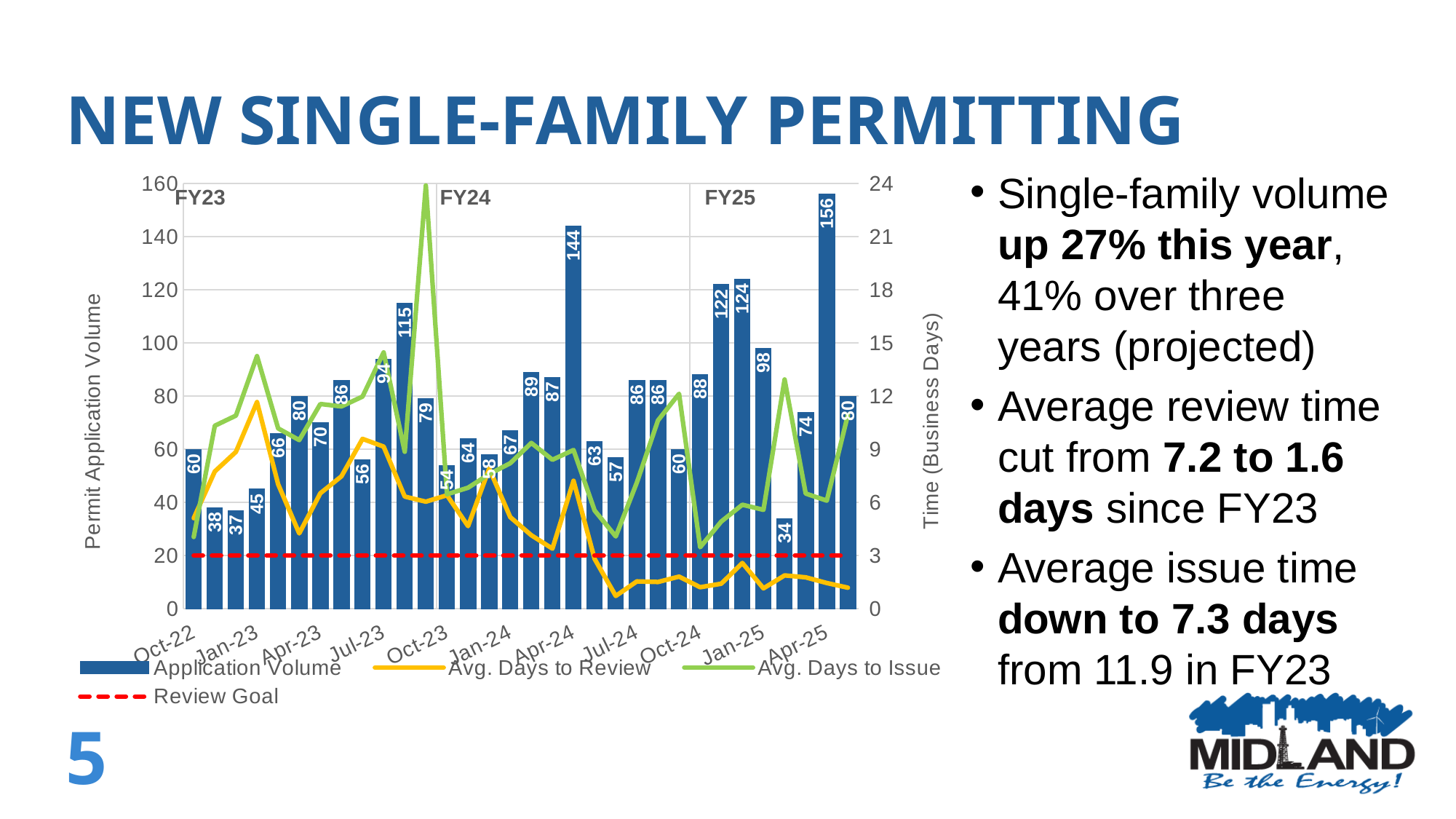
What is the highest Application Volume value shown on the chart? 156 What is the Application Volume for Oct-22? 60 What is the difference in Application Volume between Apr-25 and Apr-24? 12 Is the Review Goal line greater or less than 6 business days? less What is the maximum value shown on the right-hand Time (Business Days) axis? 24 Which has a higher Application Volume, Jan-25 or Jan-24? Jan-25 How many series does the chart legend list? 4 What type of chart is shown on the slide? Combination bar and line chart What is the Application Volume for Apr-25? 156 Which fiscal year labels are marked on the chart? FY23, FY24, FY25 What is the Application Volume for Apr-24? 144 What is the lowest Application Volume value shown on the chart? 34